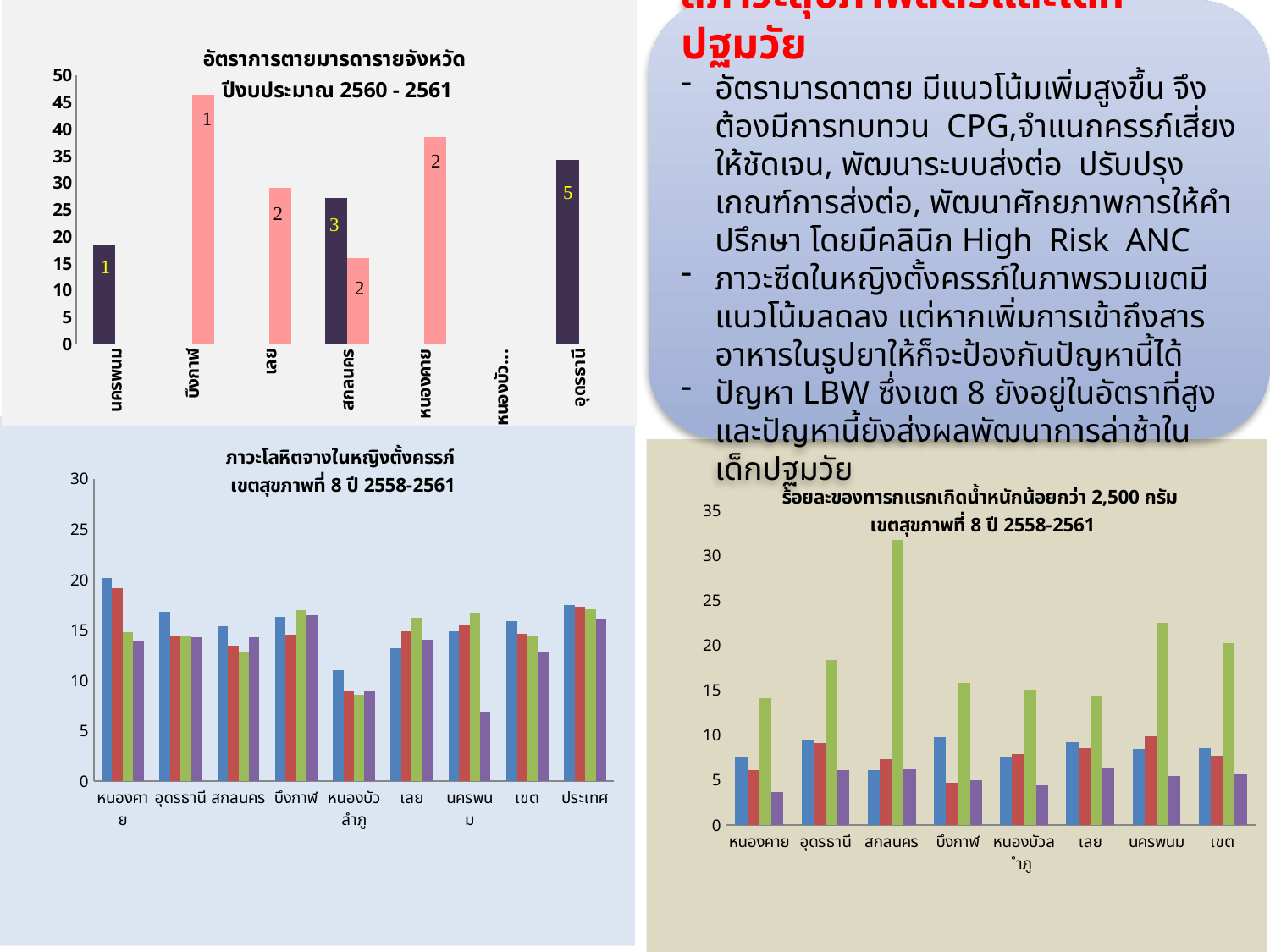
In the bottom-right chart 'ร้อยละของทารกแรกเกิดน้ำหนักน้อยกว่า 2,500 กรัม', which category has the tallest bar? สกลนคร In the top-left chart titled 'อัตราการตายมารดารายจังหวัด ปีงบประมาณ 2560 - 2561', what kind of chart is shown? bar chart In the bottom-left chart 'ภาวะโลหิตจางในหญิงตั้งครรภ์ เขตสุขภาพที่ 8 ปี 2558-2561', how many categories are shown on the x axis? 9 In the top-left chart 'อัตราการตายมารดารายจังหวัด', is the pink bar for บึงกาฬ greater or less than 40? greater In the bottom-left chart 'ภาวะโลหิตจางในหญิงตั้งครรภ์', is the blue bar for หนองคาย greater or less than 15? greater In the top-left chart 'อัตราการตายมารดารายจังหวัด', which is taller: the pink bar for หนองคาย or the dark bar for อุดรธานี? หนองคาย In the top-left chart 'อัตราการตายมารดารายจังหวัด', how many provinces/categories are listed on the x axis? 7 In the top-left chart 'อัตราการตายมารดารายจังหวัด', which category has the tallest bar? บึงกาฬ In the bottom-right chart 'ร้อยละของทารกแรกเกิดน้ำหนักน้อยกว่า 2,500 กรัม', is the green bar for สกลนคร greater or less than 30? greater In the bottom-right chart 'ร้อยละของทารกแรกเกิดน้ำหนักน้อยกว่า 2,500 กรัม', how many categories are shown on the x axis? 8